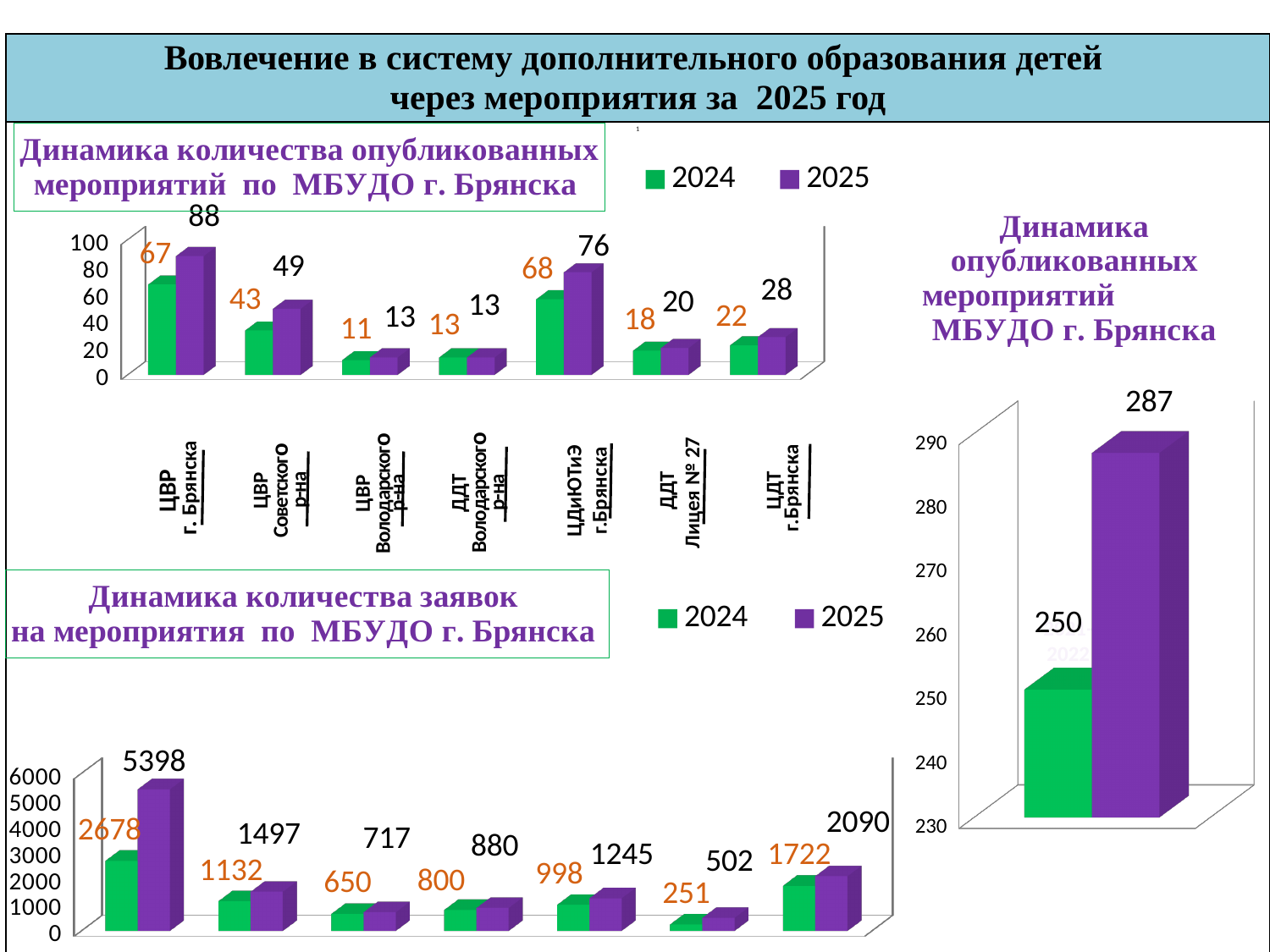
In the chart 'Динамика количества опубликованных мероприятий по МБУДО г. Брянска', what is the 2024 value for ЦВР Советского р-на? 43 In the chart 'Динамика количества опубликованных мероприятий по МБУДО г. Брянска', which category has the lowest 2024 value? ЦВР Володарского р-на In the chart 'Динамика количества опубликованных мероприятий по МБУДО г. Брянска', which is larger: the 2025 value for ЦДТ г.Брянска or the 2025 value for ДДТ Лицея № 27? ЦДТ г.Брянска In the chart 'Динамика количества заявок на мероприятия по МБУДО г. Брянска', what is the lowest 2024 value shown? 251 In the chart 'Динамика количества опубликованных мероприятий по МБУДО г. Брянска', what is the 2025 value for ЦВР г. Брянска? 88 In the chart 'Динамика количества заявок на мероприятия по МБУДО г. Брянска', what is the highest 2025 value shown? 5398 How many categories are shown in the chart 'Динамика количества опубликованных мероприятий по МБУДО г. Брянска'? 7 In the chart 'Динамика количества опубликованных мероприятий по МБУДО г. Брянска', what is the difference between the 2025 and 2024 values for ЦДиЮТиЭ г.Брянска? 8 In the chart on the right titled 'Динамика опубликованных мероприятий МБУДО г. Брянска', what is the difference between the purple bar (287) and the green bar (250)? 37 How many series does the legend of the chart 'Динамика количества заявок на мероприятия по МБУДО г. Брянска' list? 2 What kind of chart is the chart on the right titled 'Динамика опубликованных мероприятий МБУДО г. Брянска'? bar chart In the chart 'Динамика количества опубликованных мероприятий по МБУДО г. Брянска', which colour represents the 2025 series? purple